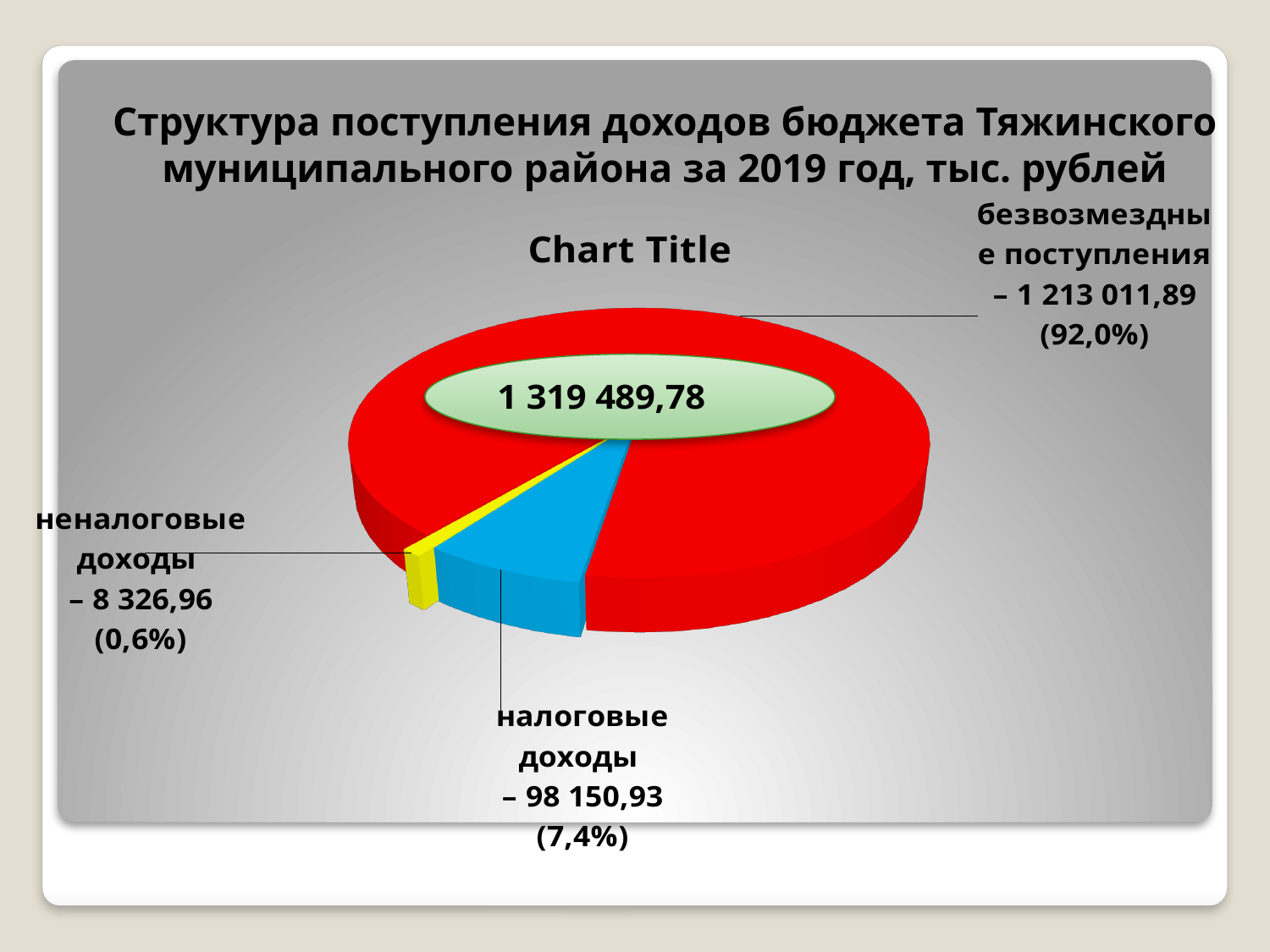
What total value is shown in the centre of the pie chart? 1 319 489,78 Which category has the smallest slice of the pie? неналоговые доходы What is the value for неналоговые доходы? 8 326,96 What is the value for налоговые доходы? 98 150,93 Which category has the largest slice of the pie? безвозмездные поступления How many slices does the pie chart have? 3 What kind of chart is shown on the slide? Pie chart What share of the pie do безвозмездные поступления make up? 92,0% Which is larger, налоговые доходы or неналоговые доходы? налоговые доходы What is the difference between the values for налоговые доходы and неналоговые доходы? 89 823,97 What share of the pie do налоговые доходы make up? 7,4% What is the value for безвозмездные поступления? 1 213 011,89